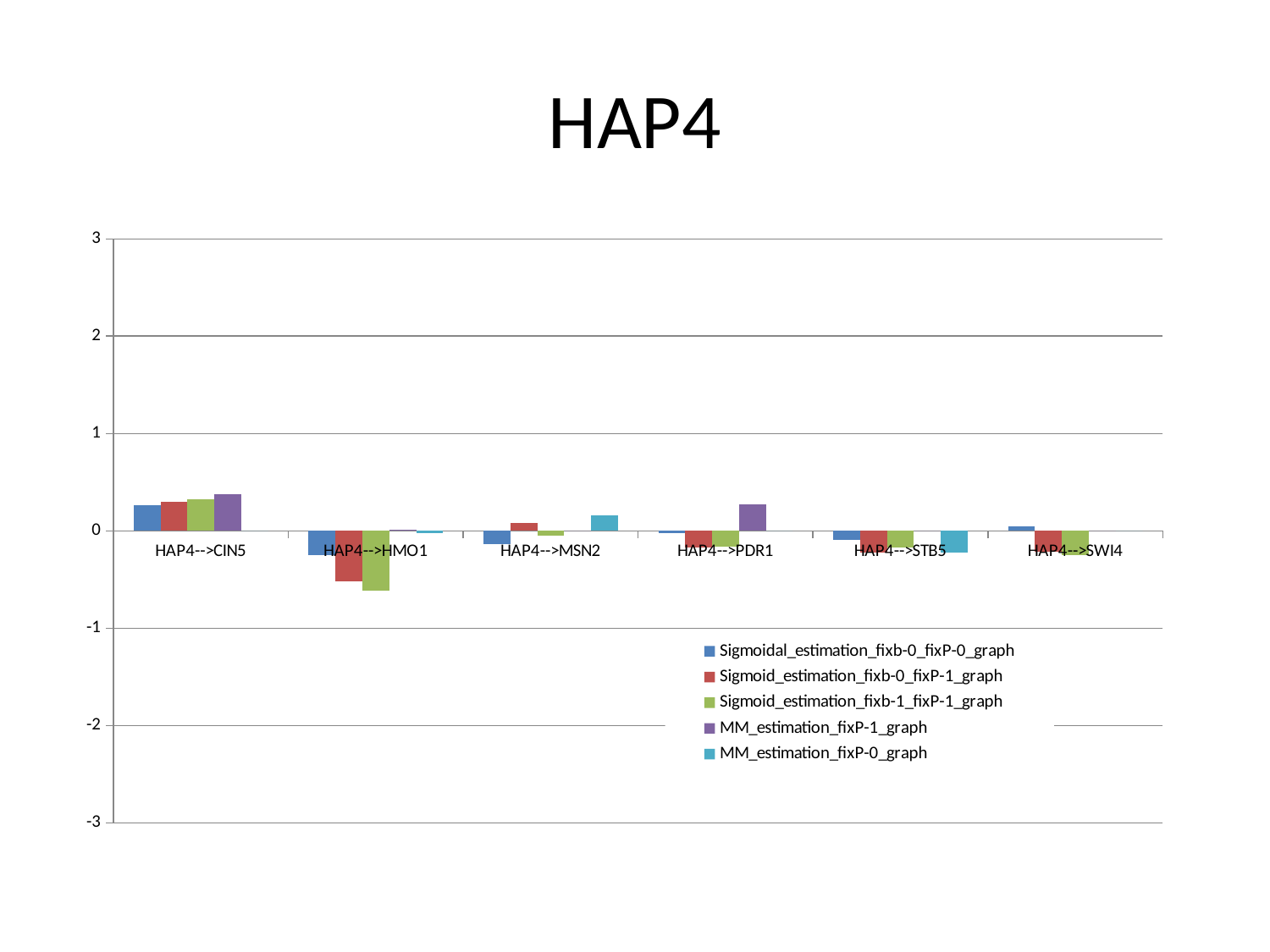
Is the value for MM_estimation_fixP-1_graph at HAP4-->CIN5 greater or less than 1? less At HAP4-->HMO1, which is larger: Sigmoid_estimation_fixb-0_fixP-1_graph or Sigmoid_estimation_fixb-1_fixP-1_graph? Sigmoid_estimation_fixb-0_fixP-1_graph What kind of chart is shown on the slide? bar chart How many series does the legend list? 5 Is the value for MM_estimation_fixP-0_graph at HAP4-->MSN2 greater or less than 0? greater Is the value for Sigmoid_estimation_fixb-0_fixP-1_graph at HAP4-->HMO1 greater or less than 0? less What is the title of the chart? HAP4 Which category has the lowest bar in the chart? HAP4-->HMO1 For MM_estimation_fixP-0_graph, which is larger: the value at HAP4-->MSN2 or at HAP4-->STB5? HAP4-->MSN2 Which series has the highest value at HAP4-->CIN5? MM_estimation_fixP-1_graph How many categories are shown on the x axis? 6